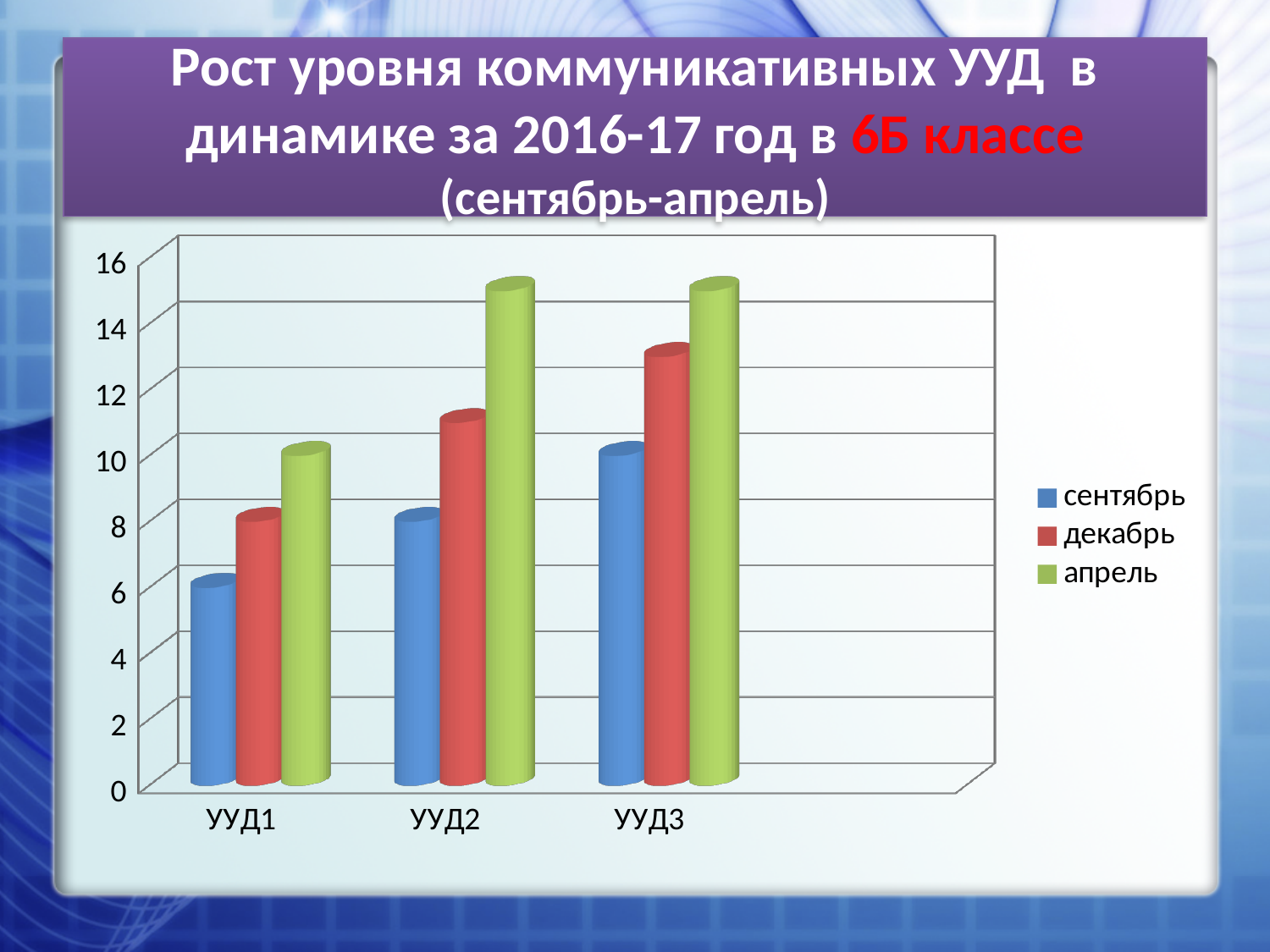
Is the value for сентябрь in УУД2 greater or less than 10? less Which category has the lowest value for апрель? УУД1 Is the value for апрель in УУД1 greater or less than 12? less Which series are listed in the legend? сентябрь, декабрь, апрель In УУД2, which is larger: the value for декабрь or the value for апрель? апрель How many categories are shown on the x axis? 3 How many series does the legend list? 3 Is the value for сентябрь in УУД1 greater or less than 8? less Which category has the highest value for сентябрь? УУД3 What kind of chart is shown on the slide? bar chart